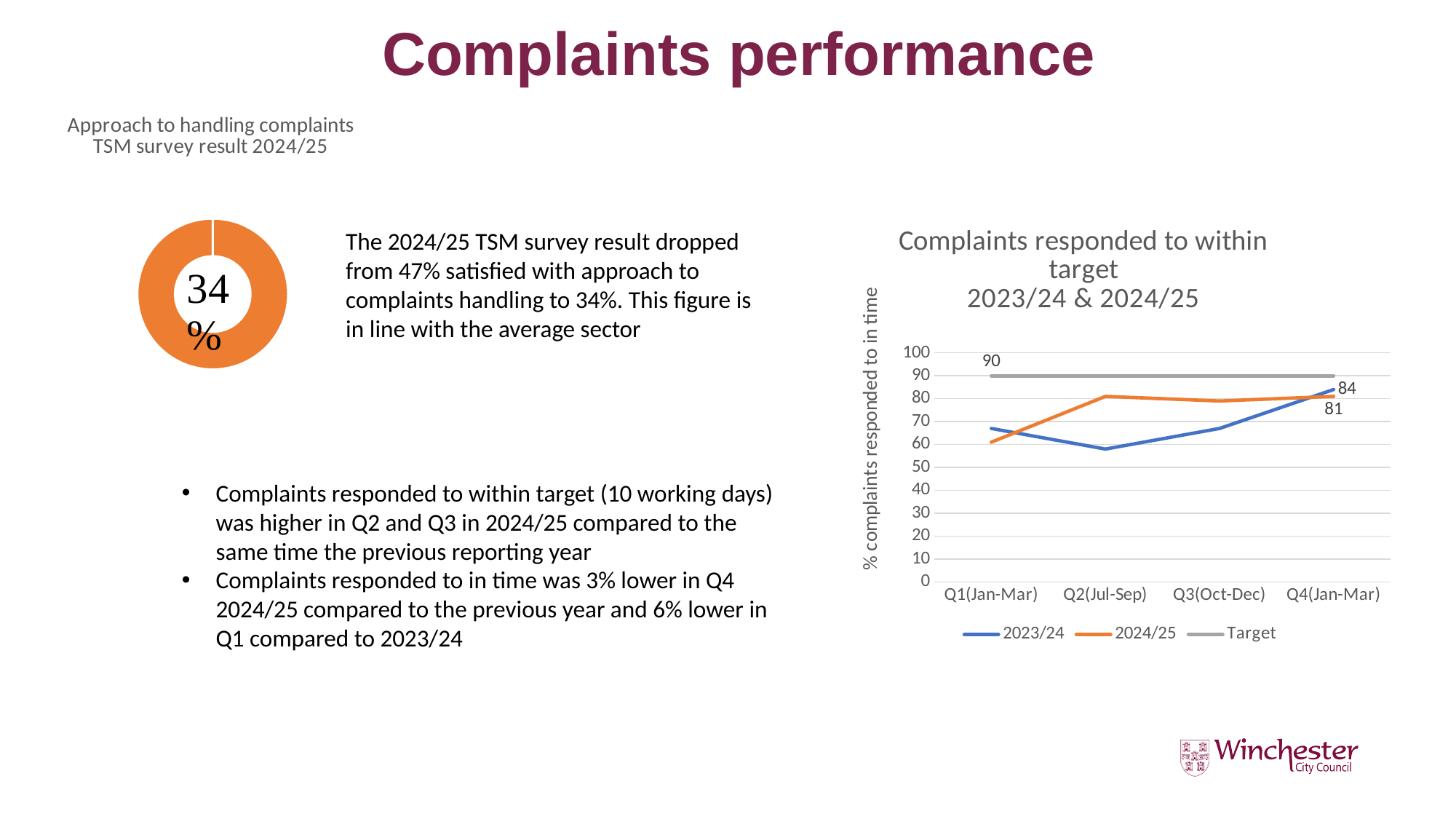
In the 'Complaints responded to within target' chart, what is the 2024/25 value for Q4(Jan-Mar)? 81 In the 'Complaints responded to within target' chart, is the 2023/24 value for Q2(Jul-Sep) greater or less than 70? less How many quarters are shown on the x axis of the 'Complaints responded to within target' chart? 4 What value is shown in the centre of the doughnut chart on the left of the slide? 34% How many series does the legend of the 'Complaints responded to within target' chart list? 3 In the 'Complaints responded to within target' chart, what is the Target value? 90 In the 'Complaints responded to within target' chart, what is the difference between the 2023/24 and 2024/25 values for Q4(Jan-Mar)? 3 In the 'Complaints responded to within target' chart, what is the 2023/24 value for Q4(Jan-Mar)? 84 In the 'Complaints responded to within target' chart, in which quarter is the 2023/24 series at its lowest? Q2(Jul-Sep) In the 'Complaints responded to within target' chart, which series has the higher value at Q2(Jul-Sep): 2023/24 or 2024/25? 2024/25 What kind of chart is the 'Complaints responded to within target' chart? line chart In the 'Complaints responded to within target' chart, does the 2024/25 series rise or fall from Q1(Jan-Mar) to Q2(Jul-Sep)? rise